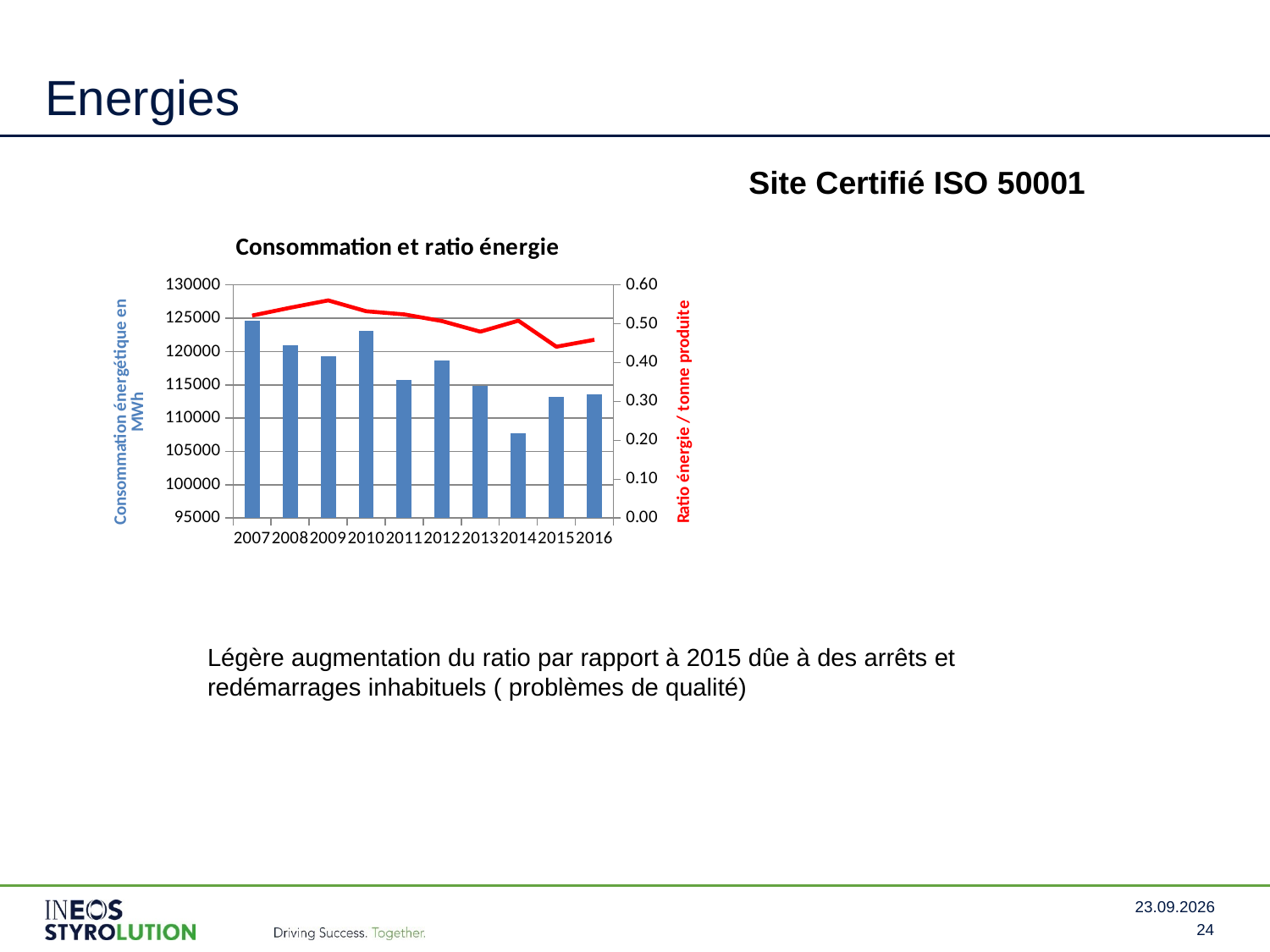
Is the energy consumption bar for 2011 greater or less than 120000 MWh? less Which year has the lowest bar for energy consumption? 2014 Which year has a higher energy consumption bar, 2010 or 2011? 2010 Is the energy consumption bar for 2007 greater or less than 120000 MWh? greater Which year has a higher energy consumption bar, 2012 or 2014? 2012 Is the ratio (red line) for 2009 greater or less than 0.50? greater Which year has the highest bar for energy consumption? 2007 How many years are shown on the x axis of the chart? 10 What is the title of the chart? Consommation et ratio énergie Overall, does the energy consumption shown by the bars rise or fall from 2007 to 2016? fall